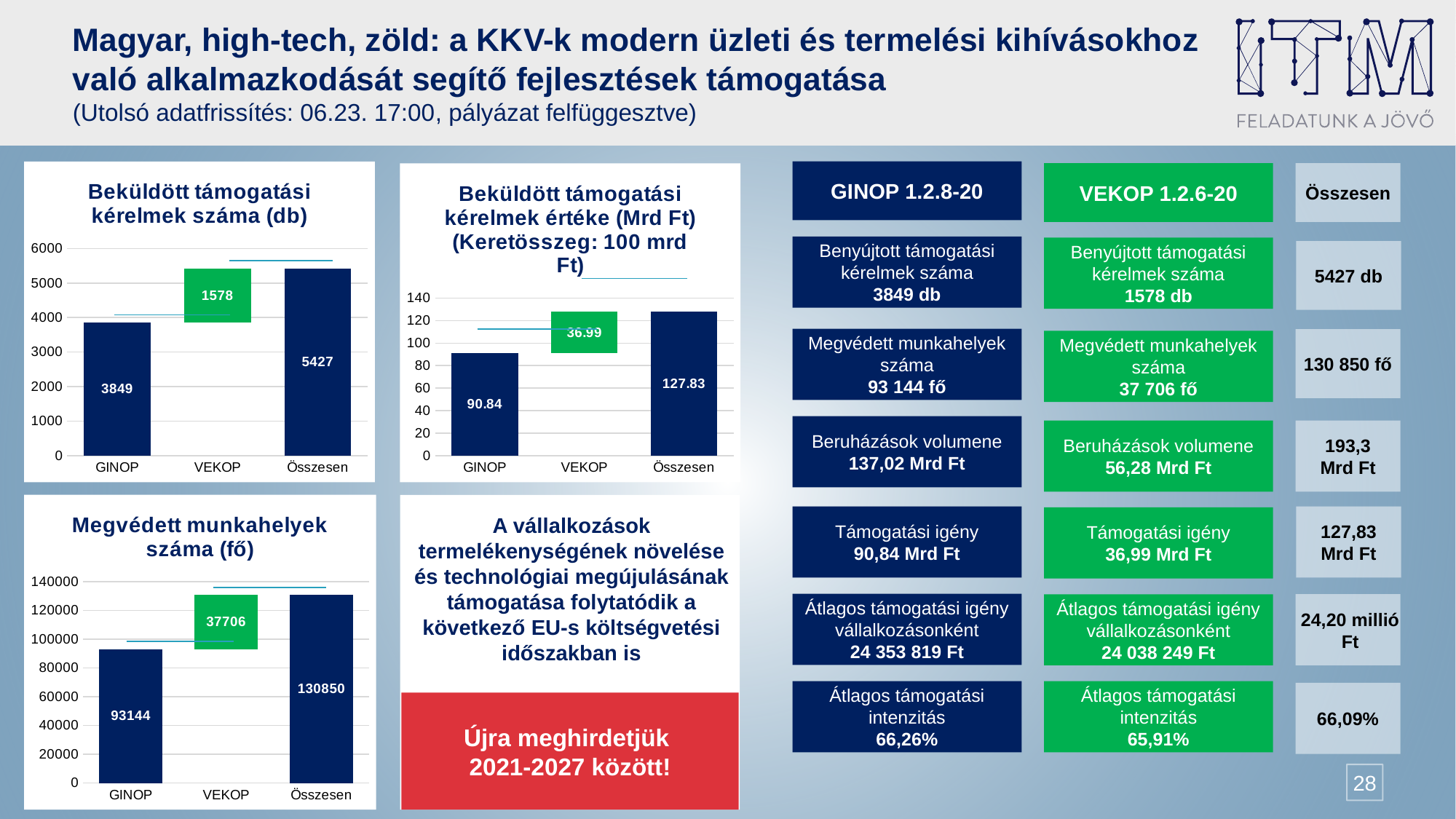
In the chart 'Beküldött támogatási kérelmek száma (db)', which category has the highest value? Összesen How many categories are shown on the x axis of the chart 'Megvédett munkahelyek száma (fő)'? 3 In the chart 'Beküldött támogatási kérelmek száma (db)', what is the value for GINOP? 3849 What kind of chart is 'Beküldött támogatási kérelmek száma (db)'? bar chart In the chart 'Beküldött támogatási kérelmek száma (db)', what is the difference between the GINOP and VEKOP values? 2271 In the chart 'Beküldött támogatási kérelmek értéke (Mrd Ft)', which category has the lowest value? VEKOP In the chart 'Megvédett munkahelyek száma (fő)', what is the difference between the Összesen and GINOP values? 37706 In the chart 'Beküldött támogatási kérelmek száma (db)', what is the value for VEKOP? 1578 In the chart 'Beküldött támogatási kérelmek értéke (Mrd Ft)', what is the value for Összesen? 127.83 In the chart 'Megvédett munkahelyek száma (fő)', what is the value for VEKOP? 37706 In the chart 'Beküldött támogatási kérelmek értéke (Mrd Ft)', is the value for GINOP greater or less than 100? less In the chart 'Megvédett munkahelyek száma (fő)', which is larger, the value for GINOP or the value for VEKOP? GINOP